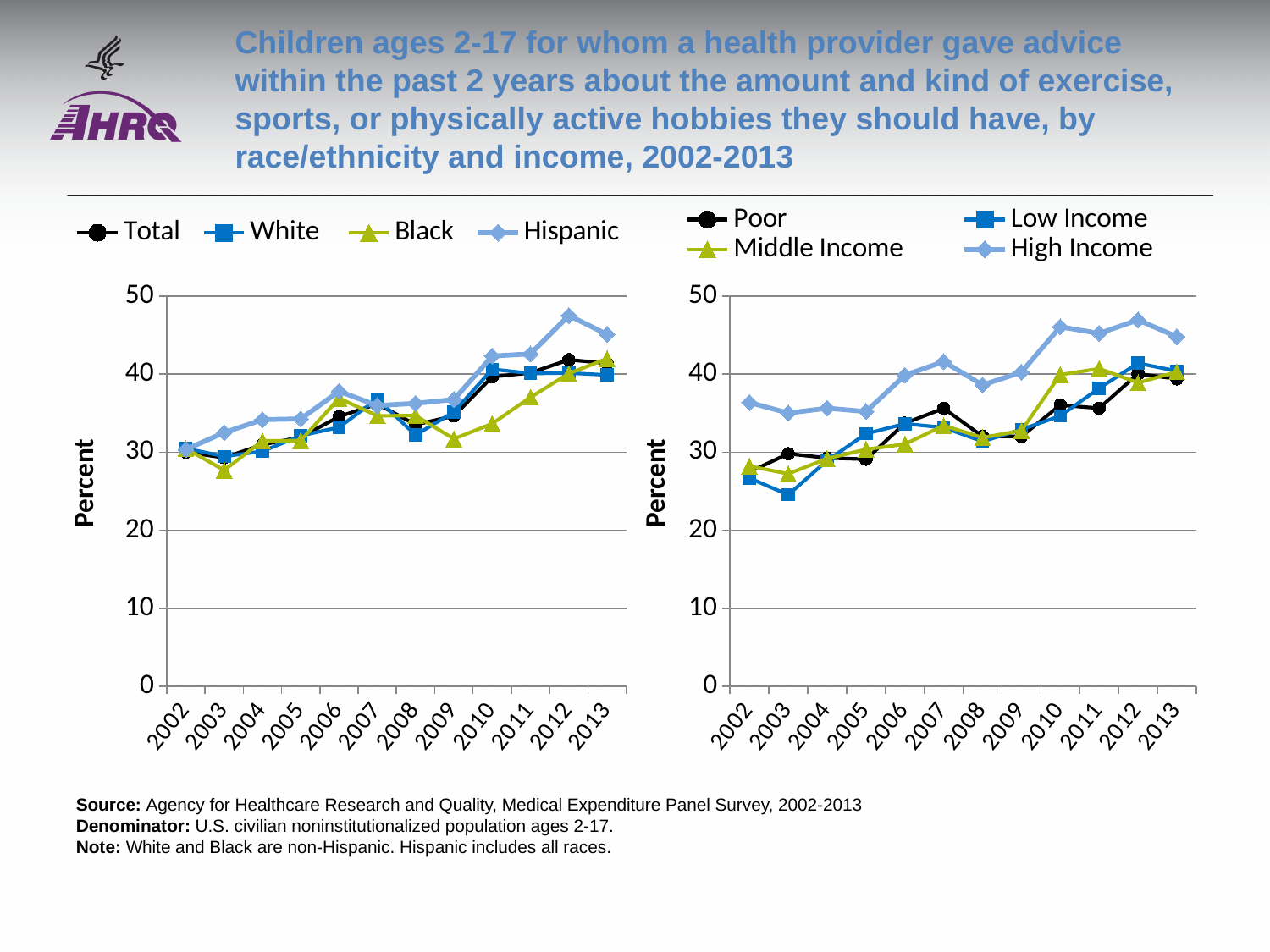
How many years are shown on the x axis of the right chart? 12 How many series does the legend of the left chart list? 4 In the right chart, does the High Income series generally rise or fall from 2002 to 2013? rise What kind of chart is the left chart (by race/ethnicity)? line chart How many series does the legend of the right chart (by income) list? 4 In the left chart, is the value for Hispanic in 2012 greater or less than 40? greater In the right chart, which series has the highest value in 2012? High Income In the left chart, which series has the highest value in 2012? Hispanic In the left chart, which series has the lowest value in 2003? Black In the right chart, which series has the lowest value in 2003? Low Income In the left chart, is the value for Black in 2003 greater or less than 30? less In the right chart, is the value for High Income in 2010 greater or less than 40? greater